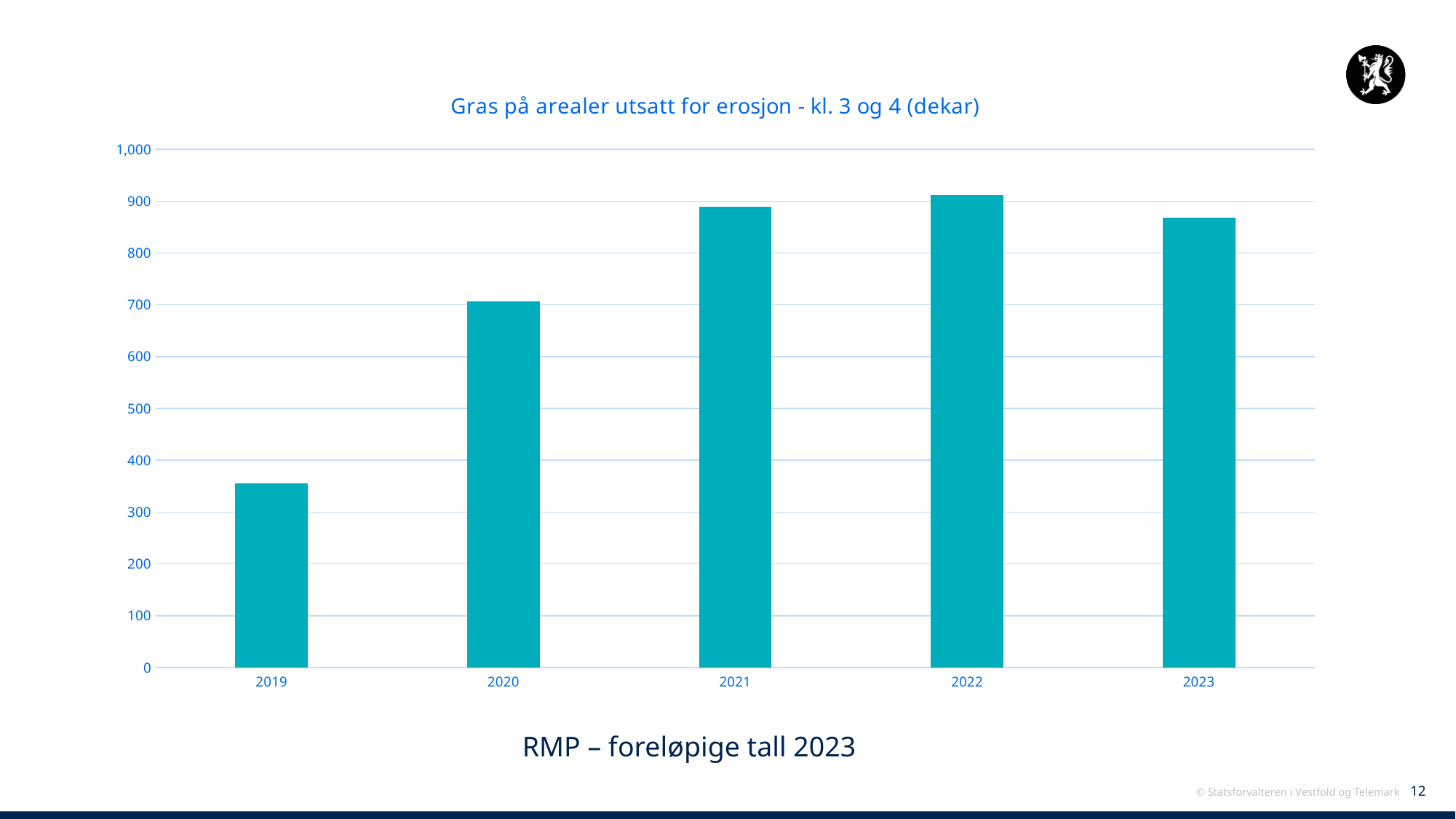
Which is larger, the value for 2022 or the value for 2023? 2022 Is the value for 2019 greater or less than 400? less How many years are shown on the x axis of the chart? 5 Which is larger, the value for 2019 or the value for 2020? 2020 Do the values rise or fall from 2019 to 2022? rise Which year has the highest value in the chart? 2022 What kind of chart is shown on the slide? Bar chart Is the value for 2023 greater or less than 900? less What is the title of the chart? Gras på arealer utsatt for erosjon - kl. 3 og 4 (dekar) Which year has the lowest value in the chart? 2019 Is the value for 2022 greater or less than 900? greater